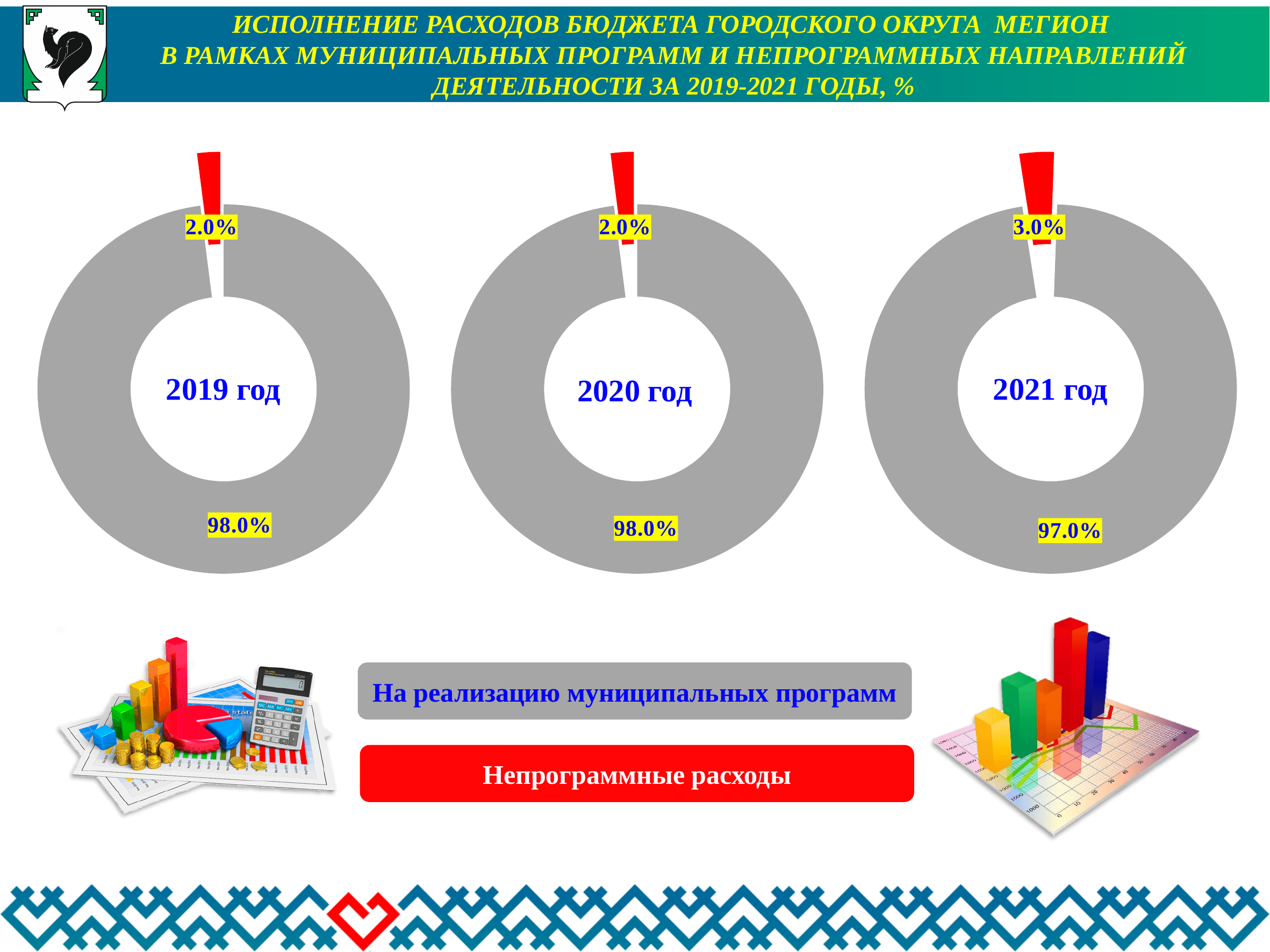
In the 2019 год chart, what share is shown for the red segment (Непрограммные расходы)? 2.0% What kind of chart is used for each year on the slide? Pie (donut) chart In the 2020 год chart, what value is labelled on the gray segment? 98.0% Across the three charts, which year has the lowest share for На реализацию муниципальных программ? 2021 год In the 2021 год chart, what value is labelled on the gray segment (На реализацию муниципальных программ)? 97.0% How many charts are shown on the slide? 3 How many segments does the 2020 год chart have? 2 Across the three charts, which year has the highest share for Непрограммные расходы? 2021 год In the 2021 год chart, what value is labelled on the red segment (Непрограммные расходы)? 3.0% In the 2019 год chart, what share is shown for the gray segment (На реализацию муниципальных программ)? 98.0% What is the difference between the gray segment value in the 2020 год chart and the gray segment value in the 2021 год chart? 1.0% Which colour represents Непрограммные расходы in the charts? Red